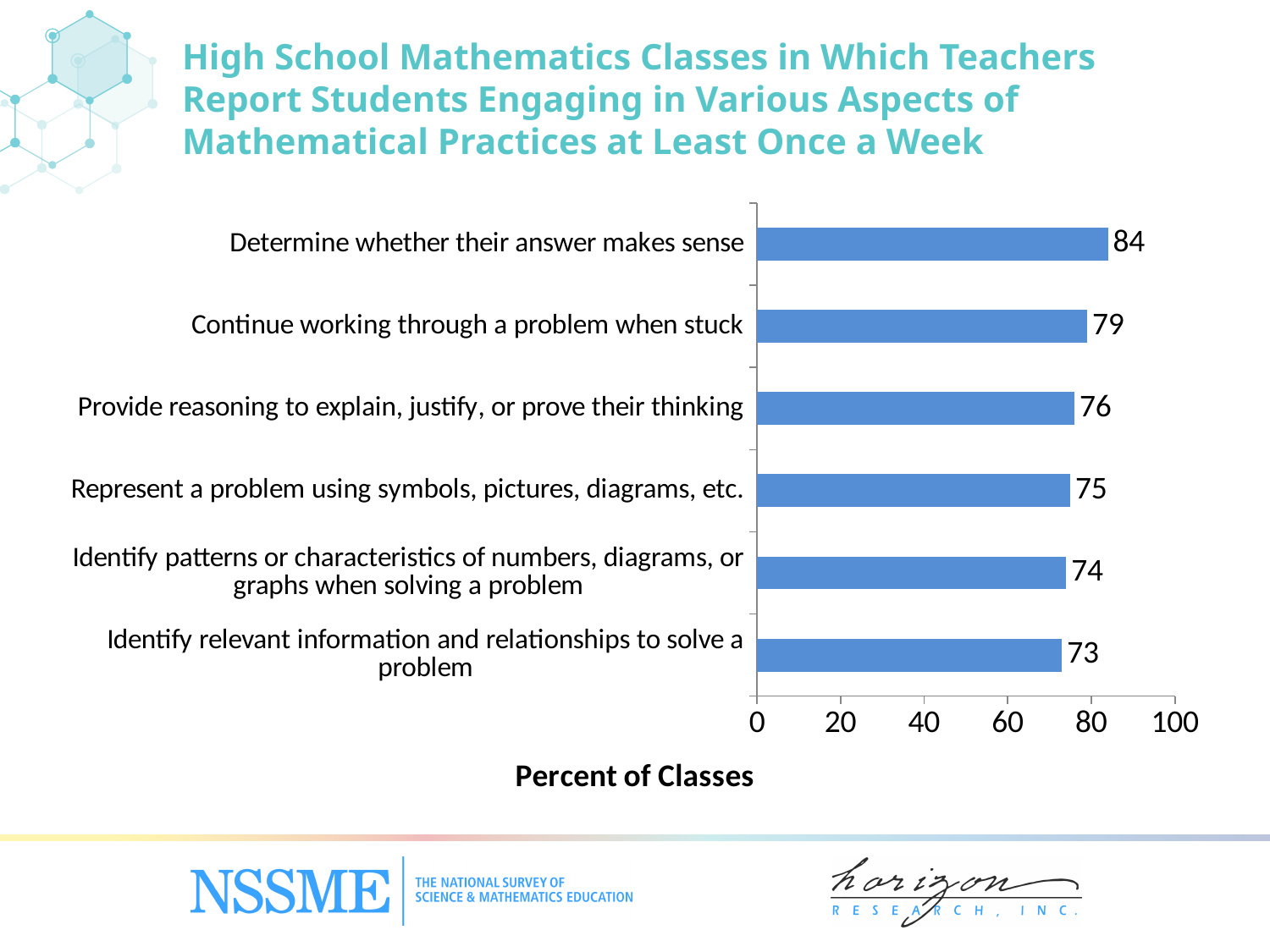
What is the difference between the values for "Continue working through a problem when stuck" and "Provide reasoning to explain, justify, or prove their thinking"? 3 Which category has the highest percent of classes? Determine whether their answer makes sense What is the value for "Identify relevant information and relationships to solve a problem"? 73 What is the value for "Continue working through a problem when stuck"? 79 What is the difference between the values for "Determine whether their answer makes sense" and "Identify relevant information and relationships to solve a problem"? 11 What kind of chart is shown on the slide? bar chart Which is larger: the value for "Represent a problem using symbols, pictures, diagrams, etc." or the value for "Identify patterns or characteristics of numbers, diagrams, or graphs when solving a problem"? Represent a problem using symbols, pictures, diagrams, etc. What is the label of the horizontal axis? Percent of Classes What percent of classes is reported for "Determine whether their answer makes sense"? 84 Which category has the lowest percent of classes? Identify relevant information and relationships to solve a problem How many categories are shown in the chart? 6 Is the value for "Provide reasoning to explain, justify, or prove their thinking" greater or less than 80? less